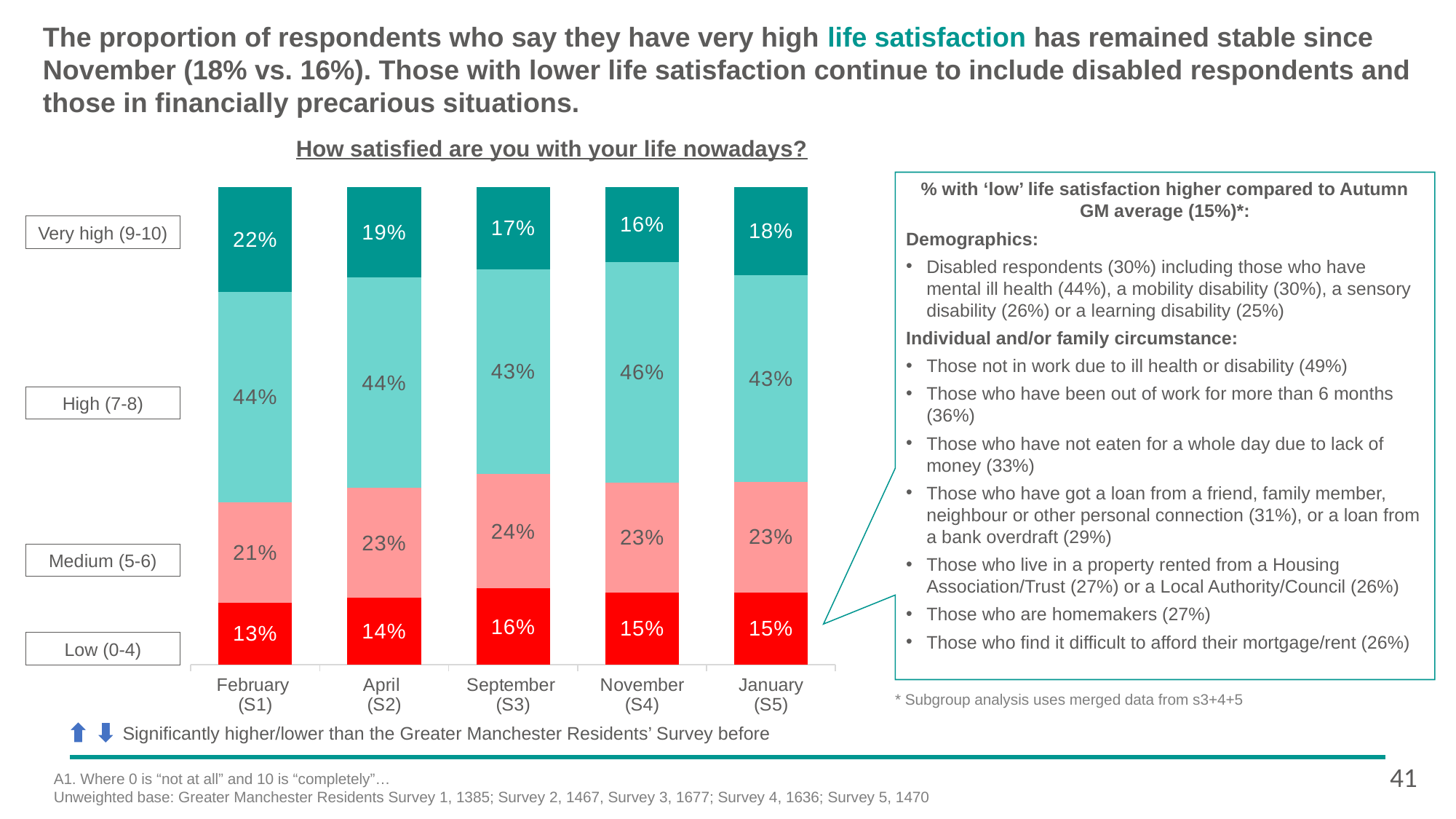
In which survey wave was the 'Very high (9-10)' share the highest? February (S1) How many survey waves are shown on the x axis of the chart? 5 By how many percentage points did the 'Very high (9-10)' share change between February (S1) and January (S5)? 4 percentage points Does the 'Very high (9-10)' share rise or fall from February (S1) to November (S4)? Fall How many satisfaction categories (series) are stacked in each bar? 4 What percentage of respondents gave a 'High (7-8)' rating in November (S4)? 46% What percentage of respondents gave a 'Very high (9-10)' life satisfaction rating in February (S1)? 22% Which wave has the larger 'High (7-8)' share, November (S4) or January (S5)? November (S4) What is the title of the chart? How satisfied are you with your life nowadays? What percentage of respondents gave a 'Low (0-4)' rating in September (S3)? 16% What type of chart is used to show life satisfaction by survey wave? Stacked bar chart In which survey wave was the 'Low (0-4)' share the lowest? February (S1)